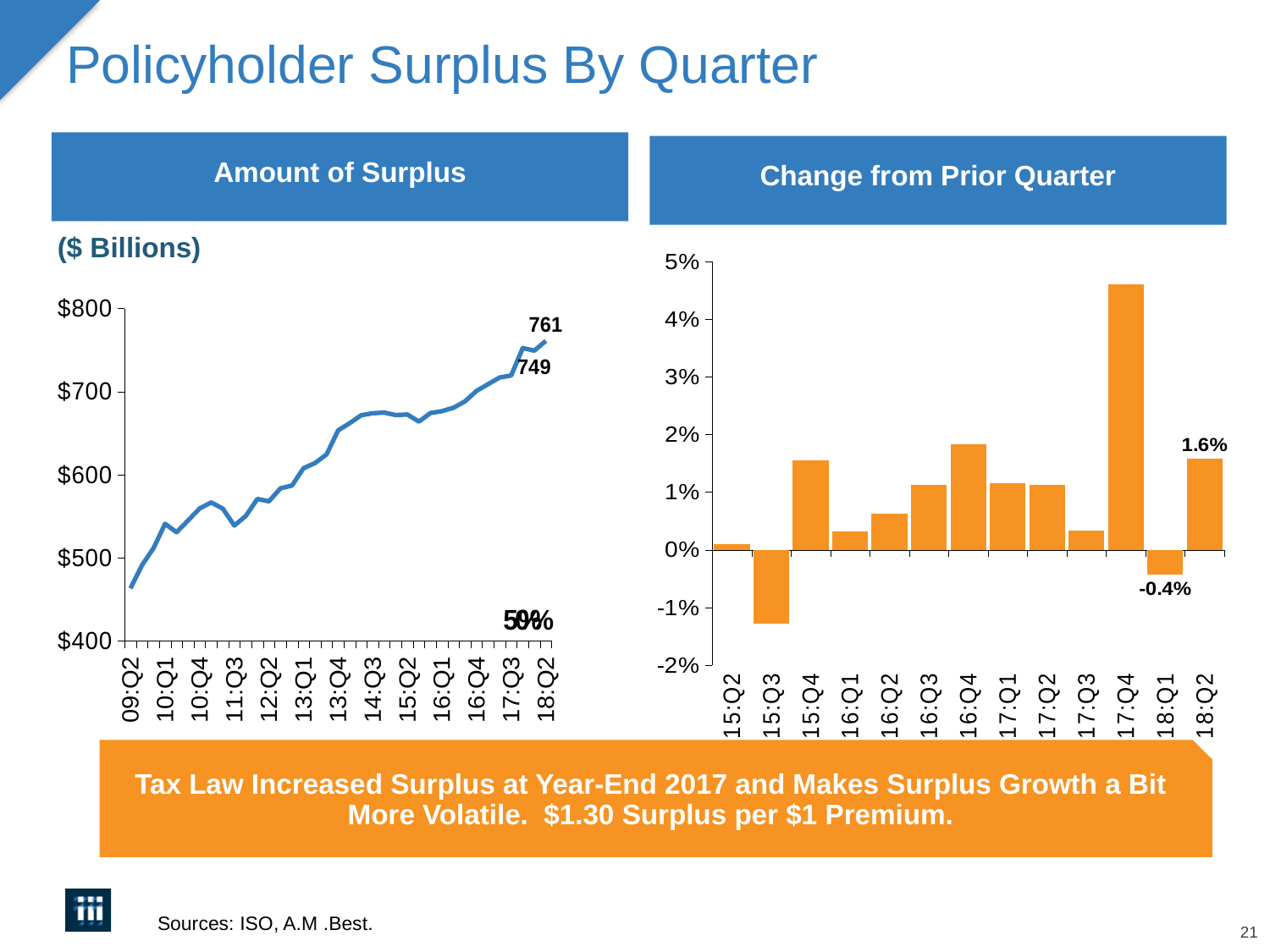
What kind of chart is the 'Amount of Surplus' chart? line chart In the 'Change from Prior Quarter' chart, which quarter has the highest change? 17:Q4 In the 'Change from Prior Quarter' chart, is the value for 17:Q4 greater or less than 4%? greater In the 'Change from Prior Quarter' chart, what is the value for 18:Q2? 1.6% In the 'Amount of Surplus' chart, do values generally rise or fall from 09:Q2 to 18:Q2? rise In the 'Change from Prior Quarter' chart, which quarter has the lowest change? 15:Q3 In the 'Change from Prior Quarter' chart, is the value for 15:Q3 greater or less than -1%? less In the 'Amount of Surplus' chart, what is the value of the final point (18:Q2)? 761 In the 'Change from Prior Quarter' chart, what is the value for 18:Q1? -0.4% In the 'Amount of Surplus' chart, what is the difference between the two labeled values 761 and 749? 12 In the 'Change from Prior Quarter' chart, how many quarters are plotted? 13 In the 'Change from Prior Quarter' chart, which is larger, the value for 18:Q1 or 18:Q2? 18:Q2